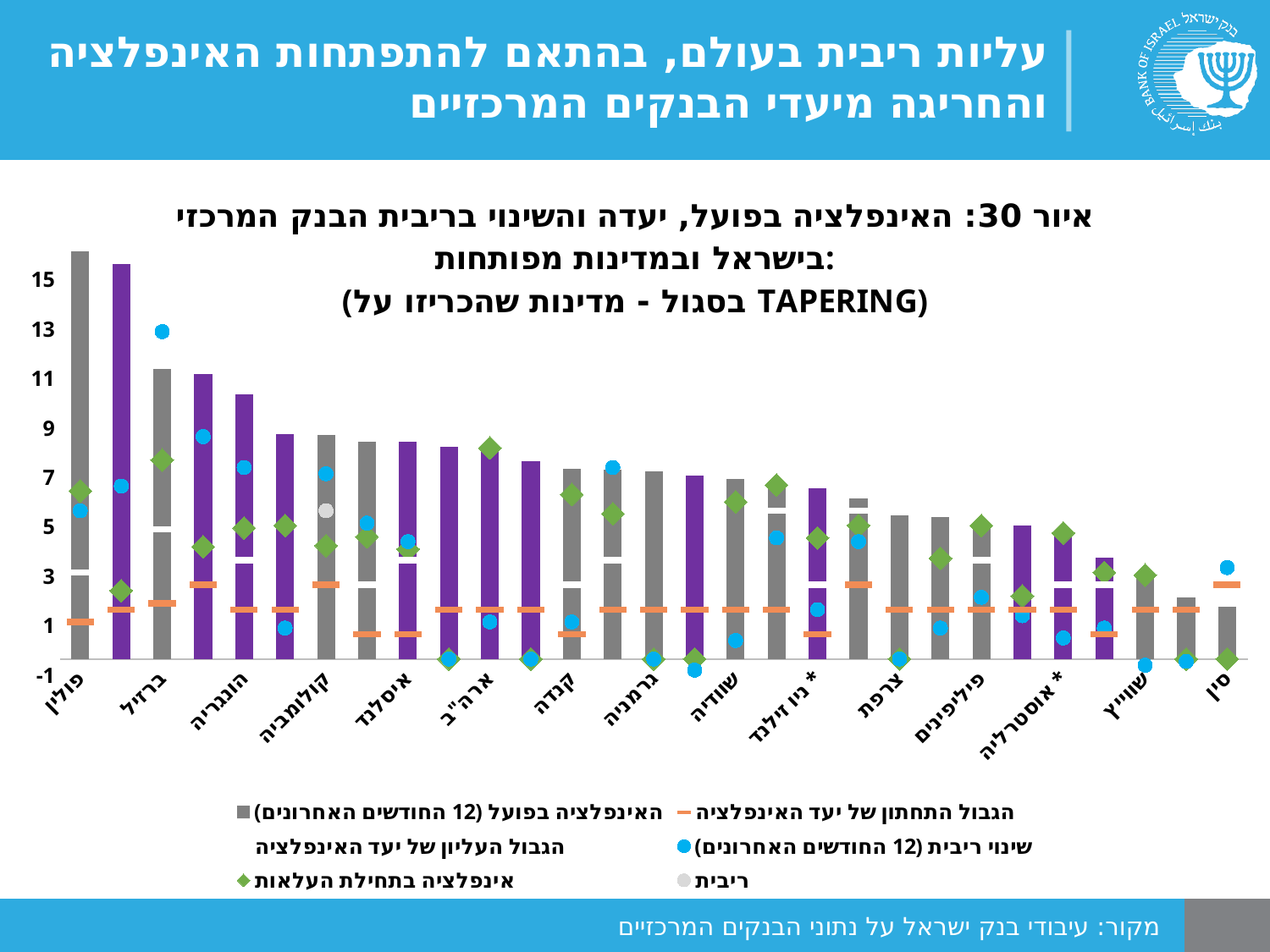
Is the actual inflation bar for Poland (פולין) greater or less than 15? greater Which has the higher actual inflation bar, Poland (פולין) or Switzerland (שווייץ)? פולין (Poland) According to the chart title, which colour marks countries that announced tapering? סגול (purple) What kind of chart is shown on the slide? bar chart Is the interest rate change (blue dot) for Hungary (הונגריה) greater or less than 7? greater Is the interest rate change (blue dot) for Brazil (ברזיל) greater or less than 11? greater How many series does the legend list? 6 Which labeled country has the lowest actual inflation bar? סין (China) Do the actual inflation bars rise or fall from left to right across the chart? fall